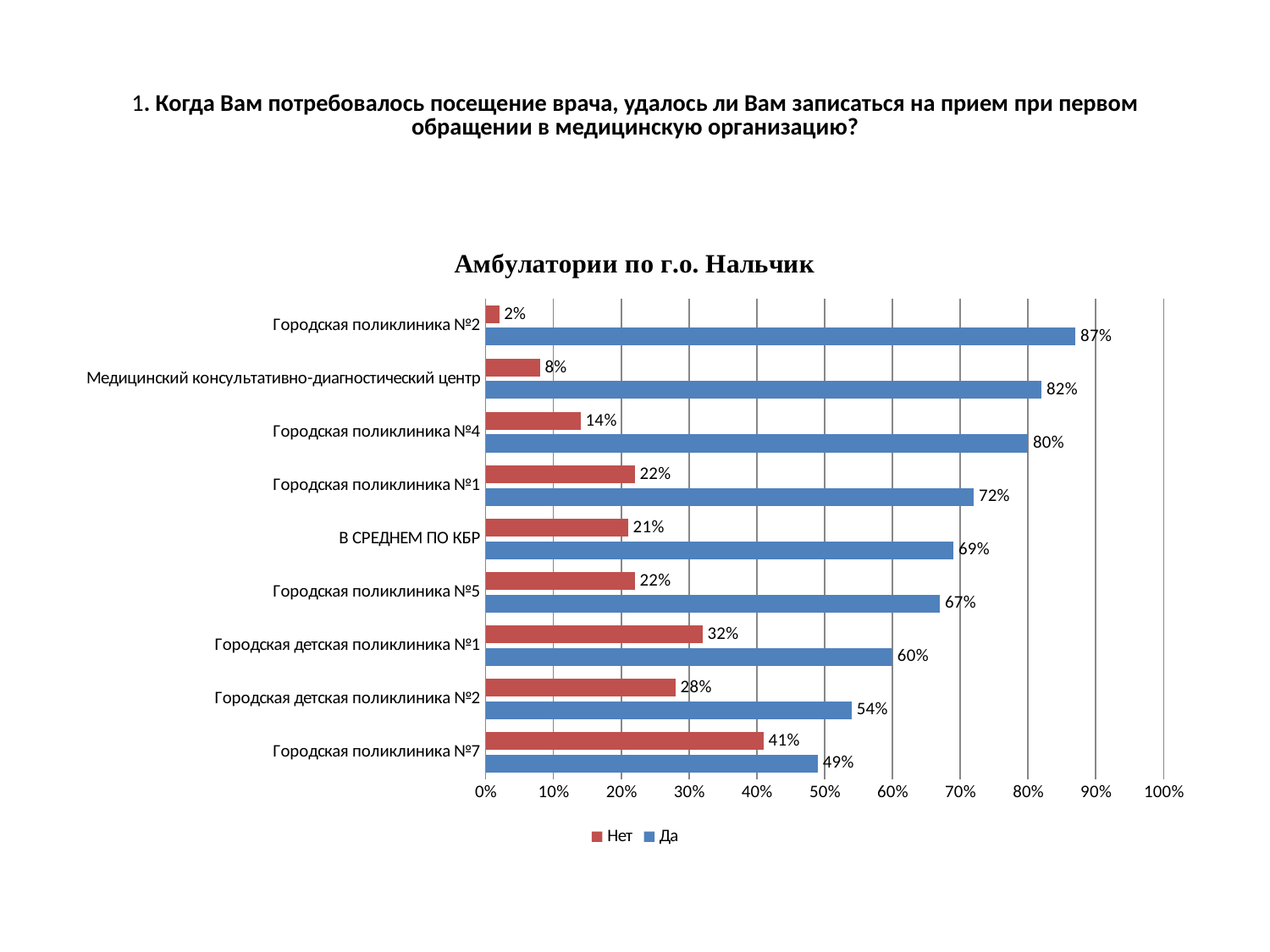
What is the title of the chart? Амбулатории по г.о. Нальчик Which category has the highest "Да" value? Городская поликлиника №2 Which is larger: the "Нет" value for Городская детская поликлиника №1 or for Городская детская поликлиника №2? Городская детская поликлиника №1 What is the "Да" value for Городская поликлиника №2? 87% Which colour represents the "Да" series? Blue What is the "Да" value for В СРЕДНЕМ ПО КБР? 69% What kind of chart is shown on the slide? Bar chart What is the "Нет" value for Городская поликлиника №7? 41% What is the difference between the "Да" and "Нет" values for Городская детская поликлиника №2? 26% How many categories are shown on the chart? 9 How many series does the legend list? 2 Which category has the lowest "Нет" value? Городская поликлиника №2